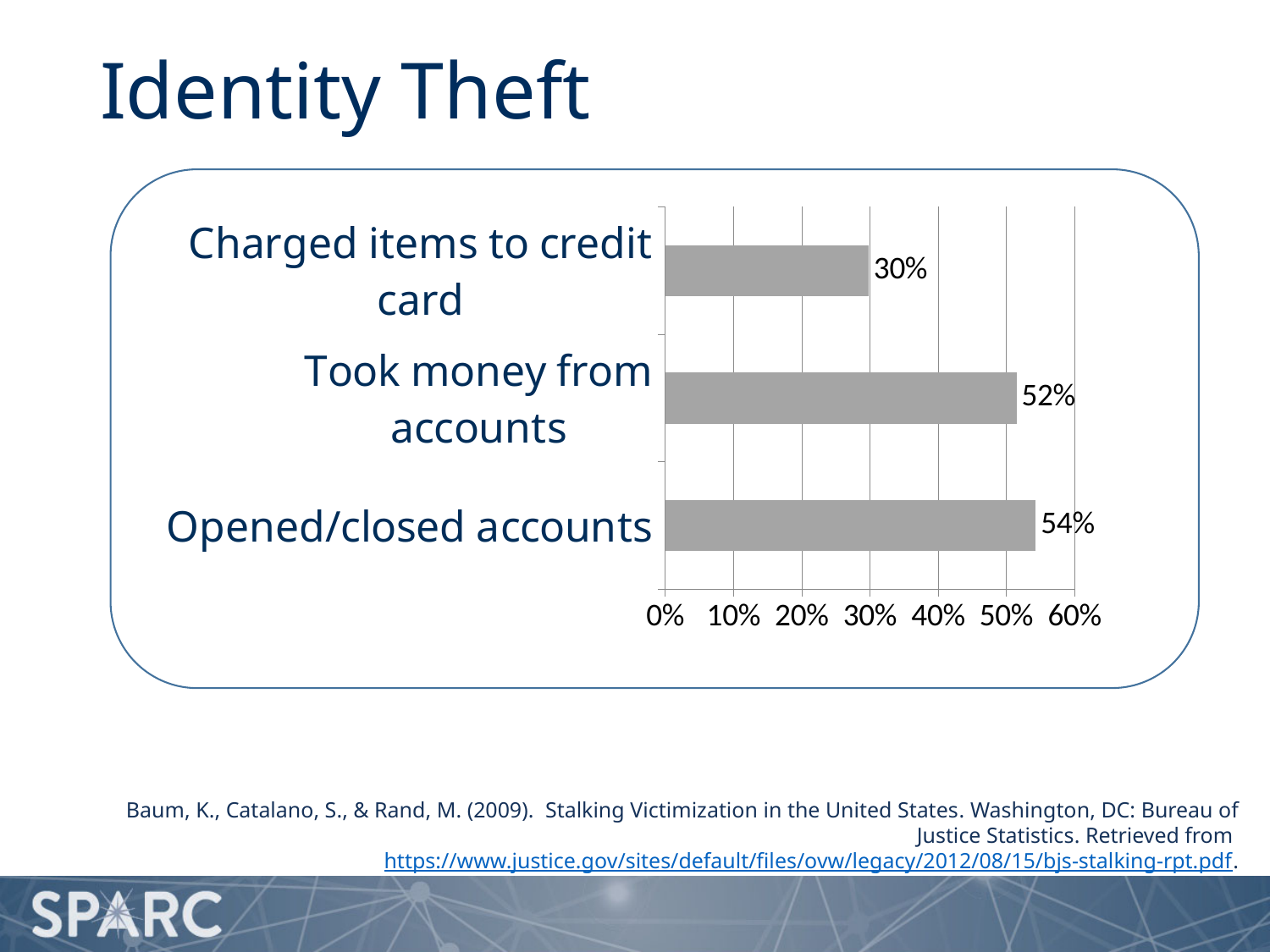
What kind of chart is shown on the slide? Bar chart What is the value for "Took money from accounts"? 52% How many categories are shown in the chart? 3 What is the value for "Charged items to credit card"? 30% What is the difference between the values for "Opened/closed accounts" and "Charged items to credit card"? 24% What is the title of the slide containing the chart? Identity Theft What is the difference between the values for "Took money from accounts" and "Charged items to credit card"? 22% What is the value for "Opened/closed accounts"? 54% Which category has the lowest value? Charged items to credit card Which category has the highest value? Opened/closed accounts Which is larger: the value for "Took money from accounts" or "Charged items to credit card"? Took money from accounts Is the value for "Took money from accounts" greater or less than 40%? greater